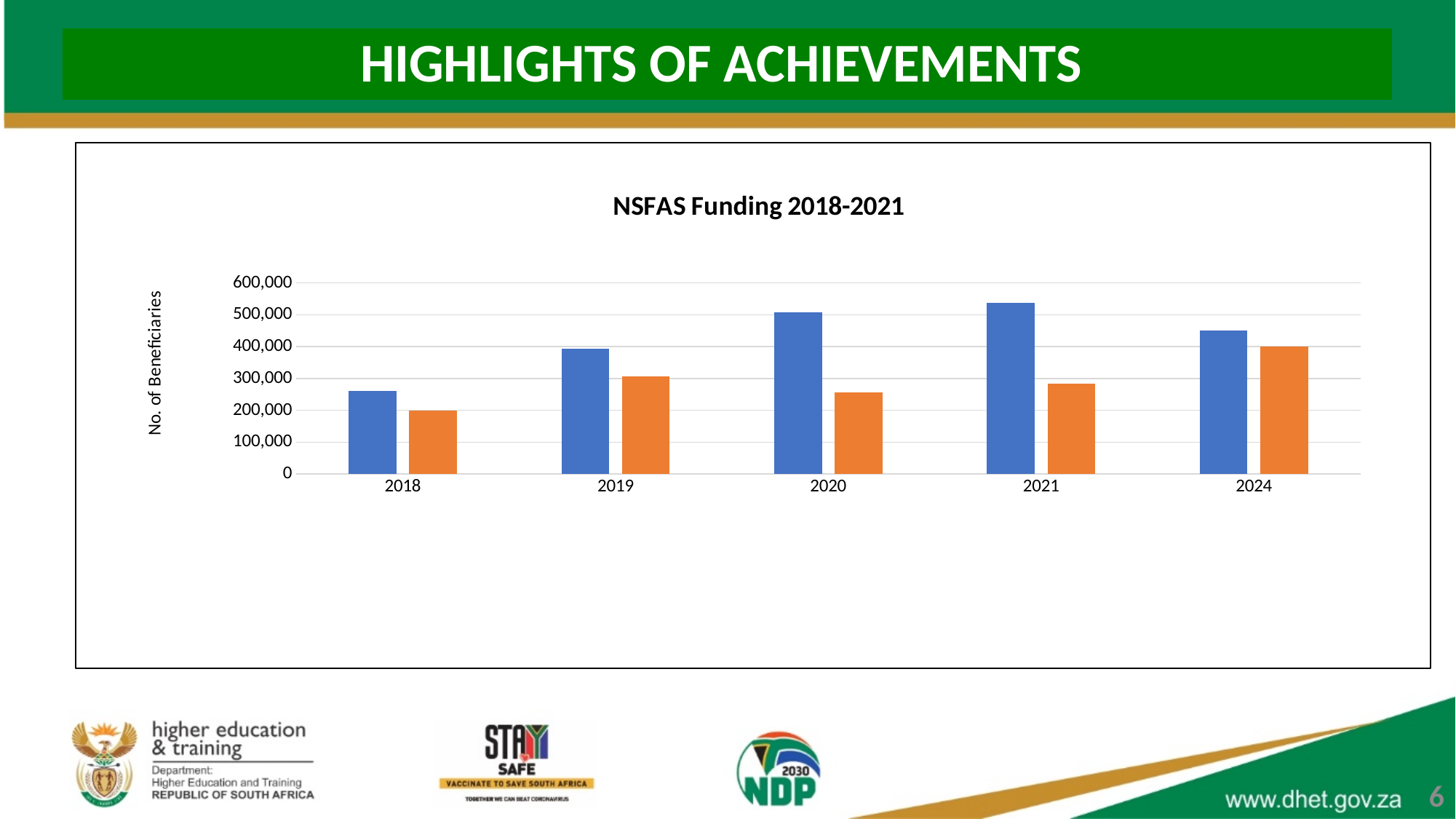
What is the label on the vertical axis of the chart? No. of Beneficiaries What is the title of the chart? NSFAS Funding 2018-2021 In which year is the blue bar the shortest? 2018 How many years are shown on the x axis of the chart? 5 Is the value of the blue bar for 2021 greater or less than 500,000? greater What kind of chart is shown on the slide? bar chart In which year is the blue bar the tallest? 2021 Which year has the taller orange bar, 2019 or 2020? 2019 In which year is the orange bar the tallest? 2024 In which year is the orange bar the shortest? 2018 Is the value of the orange bar for 2018 greater or less than 300,000? less In 2020, which bar is taller, the blue bar or the orange bar? blue